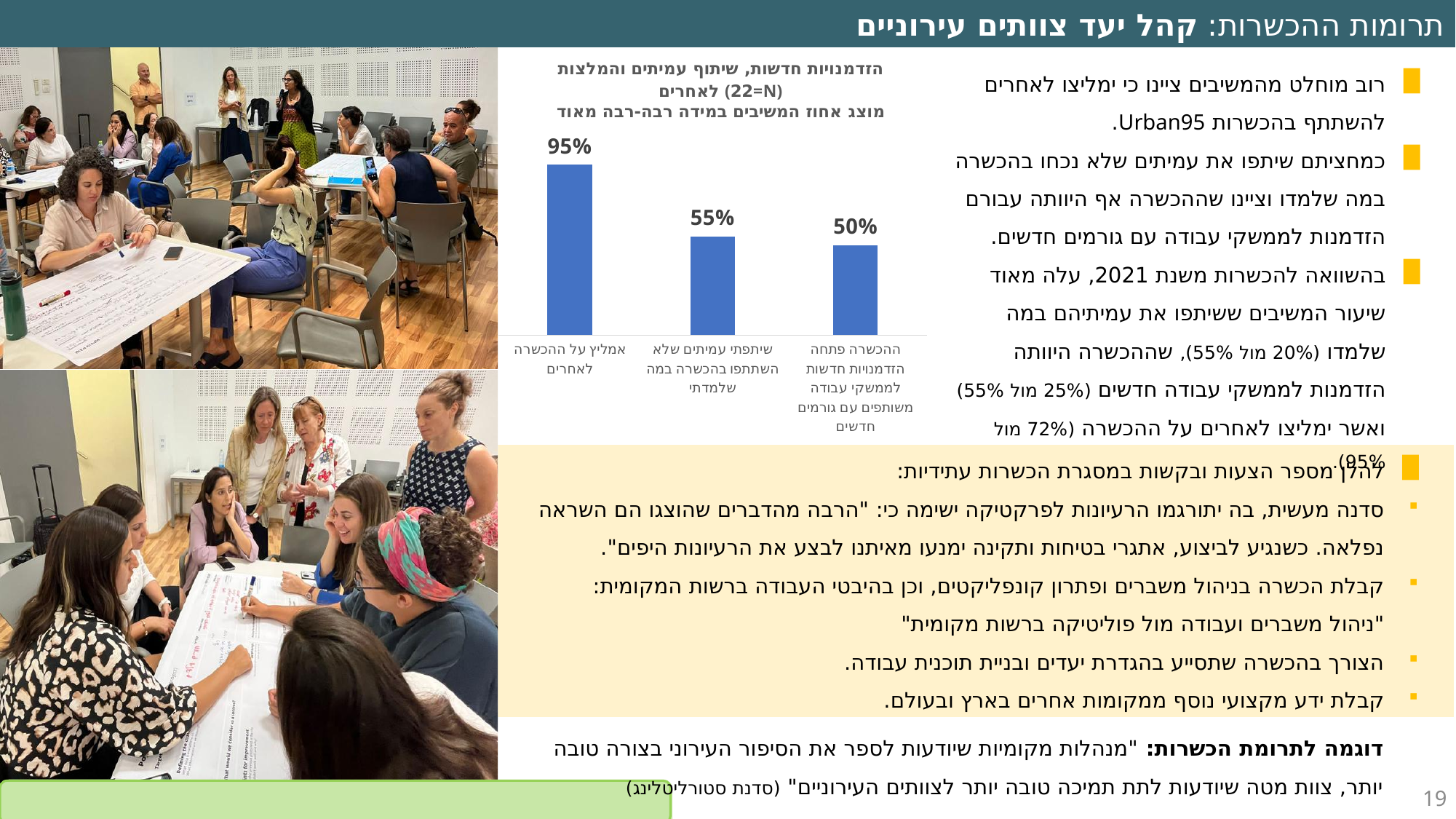
What is the difference between the value for "אמליץ על ההכשרה לאחרים" and the value for "שיתפתי עמיתים שלא השתתפו בהכשרה במה שלמדתי"? 40% What value is shown for the bar labelled "ההכשרה פתחה הזדמנויות חדשות לממשקי עבודה משותפים עם גורמים חדשים"? 50% What kind of chart is shown on the slide? Bar chart What is the difference between the value for "שיתפתי עמיתים שלא השתתפו בהכשרה במה שלמדתי" and the value for "ההכשרה פתחה הזדמנויות חדשות לממשקי עבודה משותפים עם גורמים חדשים"? 5% What value is shown for the bar labelled "שיתפתי עמיתים שלא השתתפו בהכשרה במה שלמדתי"? 55% What value is shown for the bar labelled "אמליץ על ההכשרה לאחרים"? 95% What sample size (N) is stated in the chart title? N=22 How many bars are shown in the chart? 3 Which category has the lowest value in the chart? ההכשרה פתחה הזדמנויות חדשות לממשקי עבודה משותפים עם גורמים חדשים What colour are the bars in the chart? Blue Which category has the highest value in the chart? אמליץ על ההכשרה לאחרים Which is larger: the value for "אמליץ על ההכשרה לאחרים" or the value for "ההכשרה פתחה הזדמנויות חדשות לממשקי עבודה משותפים עם גורמים חדשים"? אמליץ על ההכשרה לאחרים